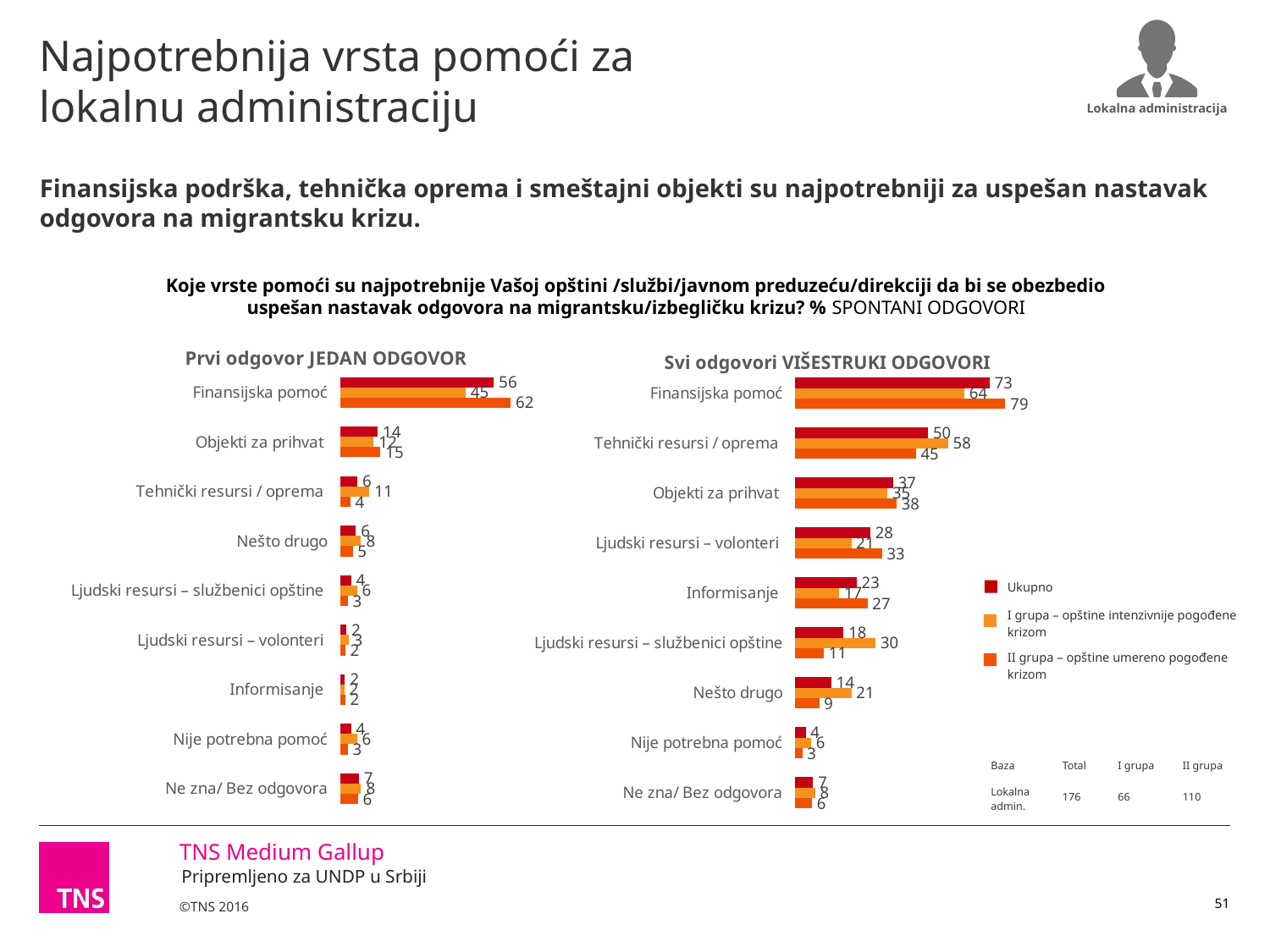
In the 'Prvi odgovor JEDAN ODGOVOR' chart, what is the Ukupno value for Finansijska pomoć? 56 How many series does the legend list? 3 In the 'Svi odgovori VIŠESTRUKI ODGOVORI' chart, what is the difference between the II grupa and I grupa values for Finansijska pomoć? 15 In the 'Prvi odgovor JEDAN ODGOVOR' chart, which category has the highest Ukupno value? Finansijska pomoć What kind of chart is the 'Prvi odgovor JEDAN ODGOVOR' chart? Bar chart In the 'Svi odgovori VIŠESTRUKI ODGOVORI' chart, which category has the lowest Ukupno value? Nije potrebna pomoć How many categories are shown in the 'Svi odgovori VIŠESTRUKI ODGOVORI' chart? 9 In the 'Svi odgovori VIŠESTRUKI ODGOVORI' chart, which is larger for Ljudski resursi – službenici opštine: the I grupa value or the II grupa value? I grupa In the 'Svi odgovori VIŠESTRUKI ODGOVORI' chart, what is the II grupa value for Finansijska pomoć? 79 In the 'Svi odgovori VIŠESTRUKI ODGOVORI' chart, what is the Ukupno value for Objekti za prihvat? 37 In the 'Svi odgovori VIŠESTRUKI ODGOVORI' chart, what is the I grupa value for Tehnički resursi / oprema? 58 In the 'Prvi odgovor JEDAN ODGOVOR' chart, which is larger for Tehnički resursi / oprema: the I grupa value or the II grupa value? I grupa